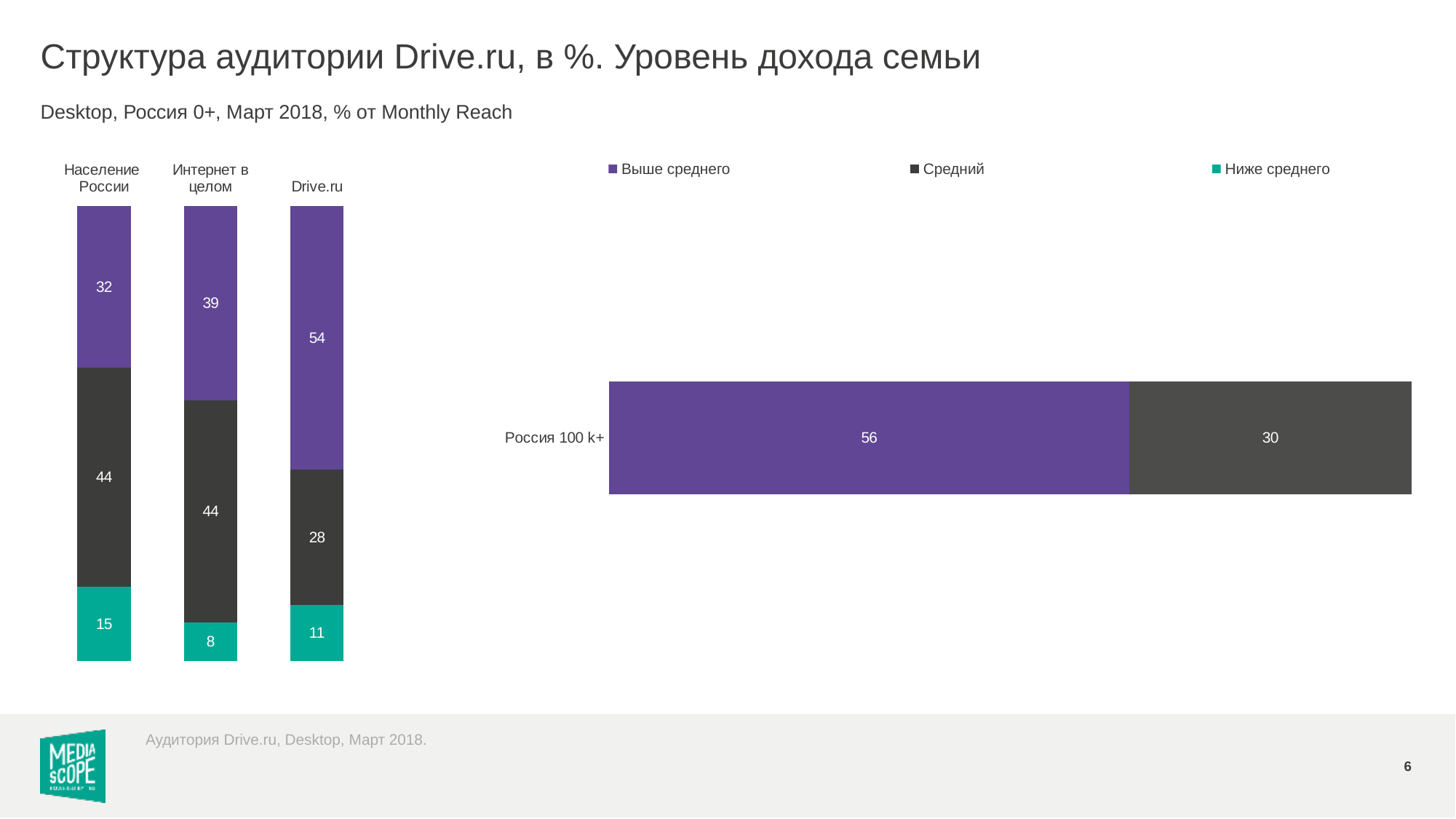
On the left chart, which is larger: the 'Средний' value for Drive.ru or for 'Население России'? Население России On the left chart, what is the value of the 'Средний' segment for 'Интернет в целом'? 44 On the left chart, which category has the lowest 'Ниже среднего' value? Интернет в целом On the left chart, what is the value of the 'Ниже среднего' segment for 'Население России'? 15 On the right chart, what is the value of the 'Выше среднего' segment for 'Россия 100 k+'? 56 On the left chart, what is the difference between the 'Выше среднего' values for Drive.ru and 'Население России'? 22 On the left chart, what is the value of the 'Выше среднего' segment for Drive.ru? 54 How many series does the legend list? 3 What type of chart is the right chart? Stacked bar chart On the left chart, which category has the highest 'Выше среднего' value? Drive.ru On the right chart, what is the value of the 'Средний' segment for 'Россия 100 k+'? 30 How many categories are shown on the left chart? 3